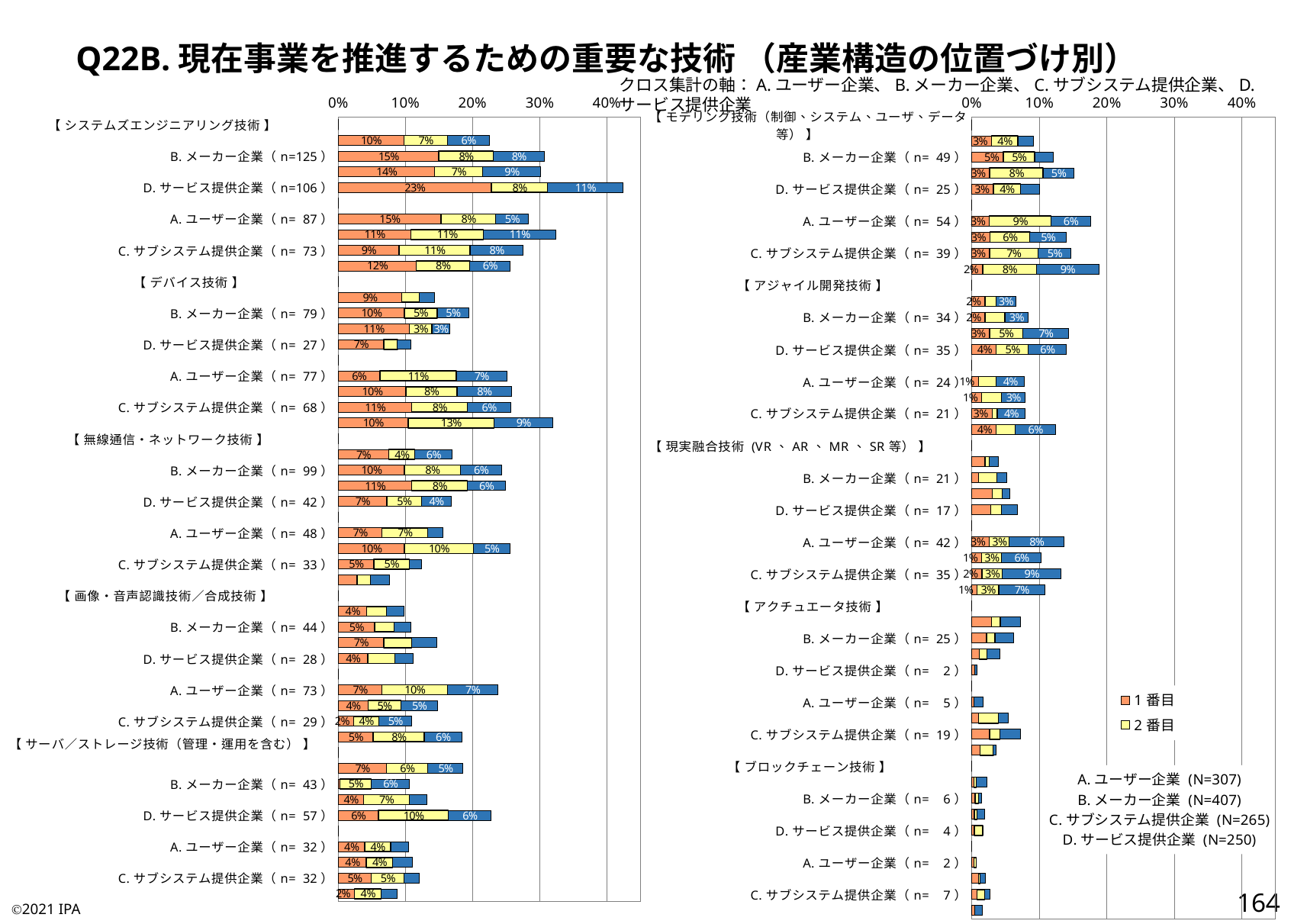
In the left chart, what is the largest value labeled for the 1 番目 (orange) series? 23% What are the two entries shown in the legend? 1 番目 and 2 番目 How many technology groups (bracketed headings) are shown in the left chart? 5 How many technology groups (bracketed headings) are shown in the right chart? 5 How many series does the legend on the slide list? 2 Which chart contains the longer longest bar, the left chart or the right chart? the left chart In the left chart, is the total of the longest bar greater or less than 40%? greater In the right chart, what is the largest value labeled for the 1 番目 (orange) series? 5% What kind of chart is the chart on the left side of the slide? bar chart According to the text box on the slide, what is the N for A. ユーザー企業? N=307 In the left chart, what is the total of the longest bar, whose segments are labeled 23%, 8% and 11%? 42%